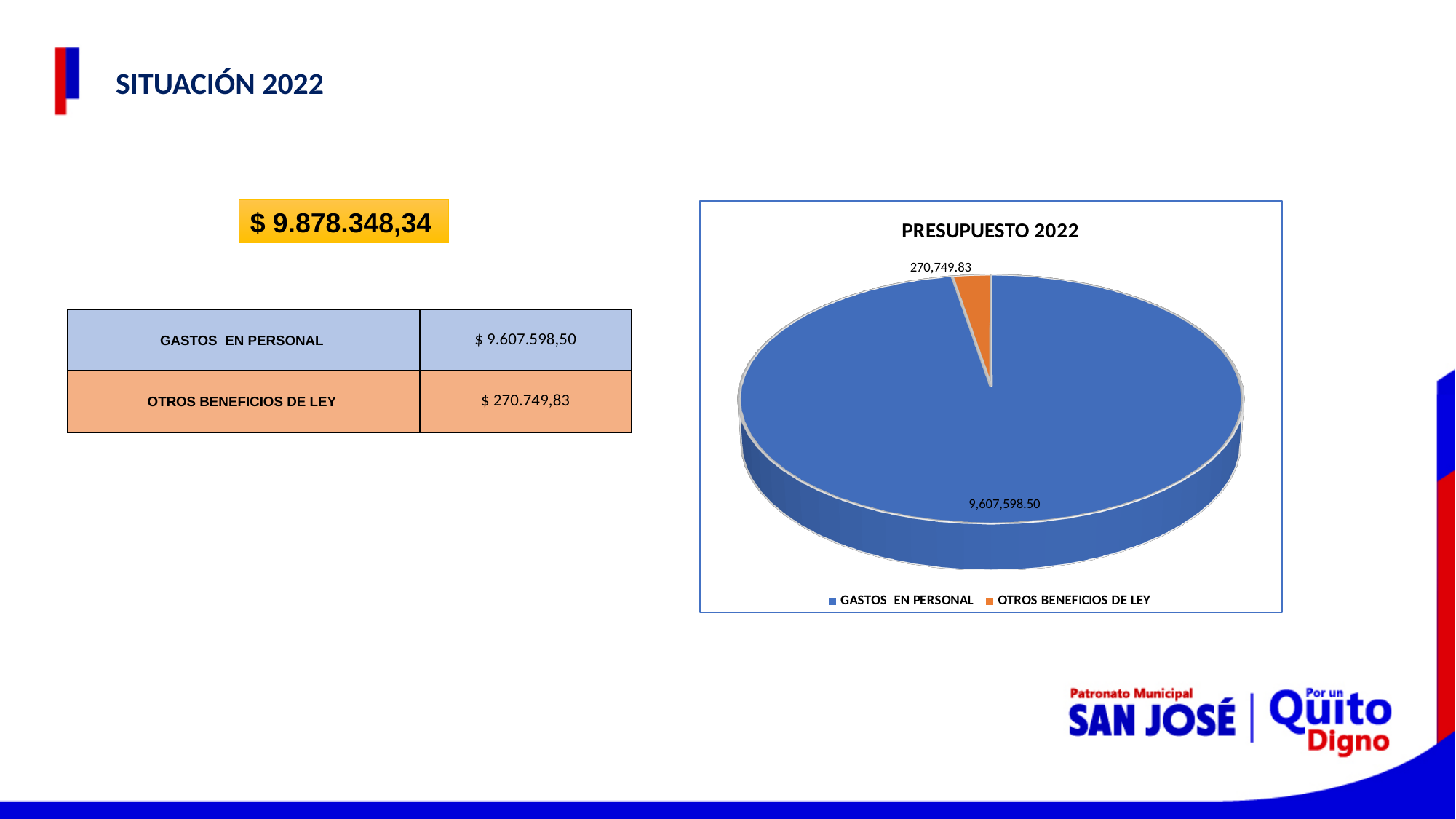
What colour is the OTROS BENEFICIOS DE LEY slice in the pie chart? Orange What value is labelled on the OTROS BENEFICIOS DE LEY slice of the pie chart? 270,749.83 Which category has the largest slice in the pie chart? GASTOS EN PERSONAL What is the total of the two values shown in the pie chart? 9,878,348.33 Which category has the smallest slice in the pie chart? OTROS BENEFICIOS DE LEY What is the title of the chart on the slide? PRESUPUESTO 2022 How many slices does the pie chart have? 2 What value is labelled on the GASTOS EN PERSONAL slice of the pie chart? 9,607,598.50 Which is larger in the pie chart, GASTOS EN PERSONAL or OTROS BENEFICIOS DE LEY? GASTOS EN PERSONAL How many entries does the legend of the pie chart list? 2 What type of chart is shown under the title PRESUPUESTO 2022? Pie chart What is the difference between the GASTOS EN PERSONAL value and the OTROS BENEFICIOS DE LEY value in the pie chart? 9,336,848.67